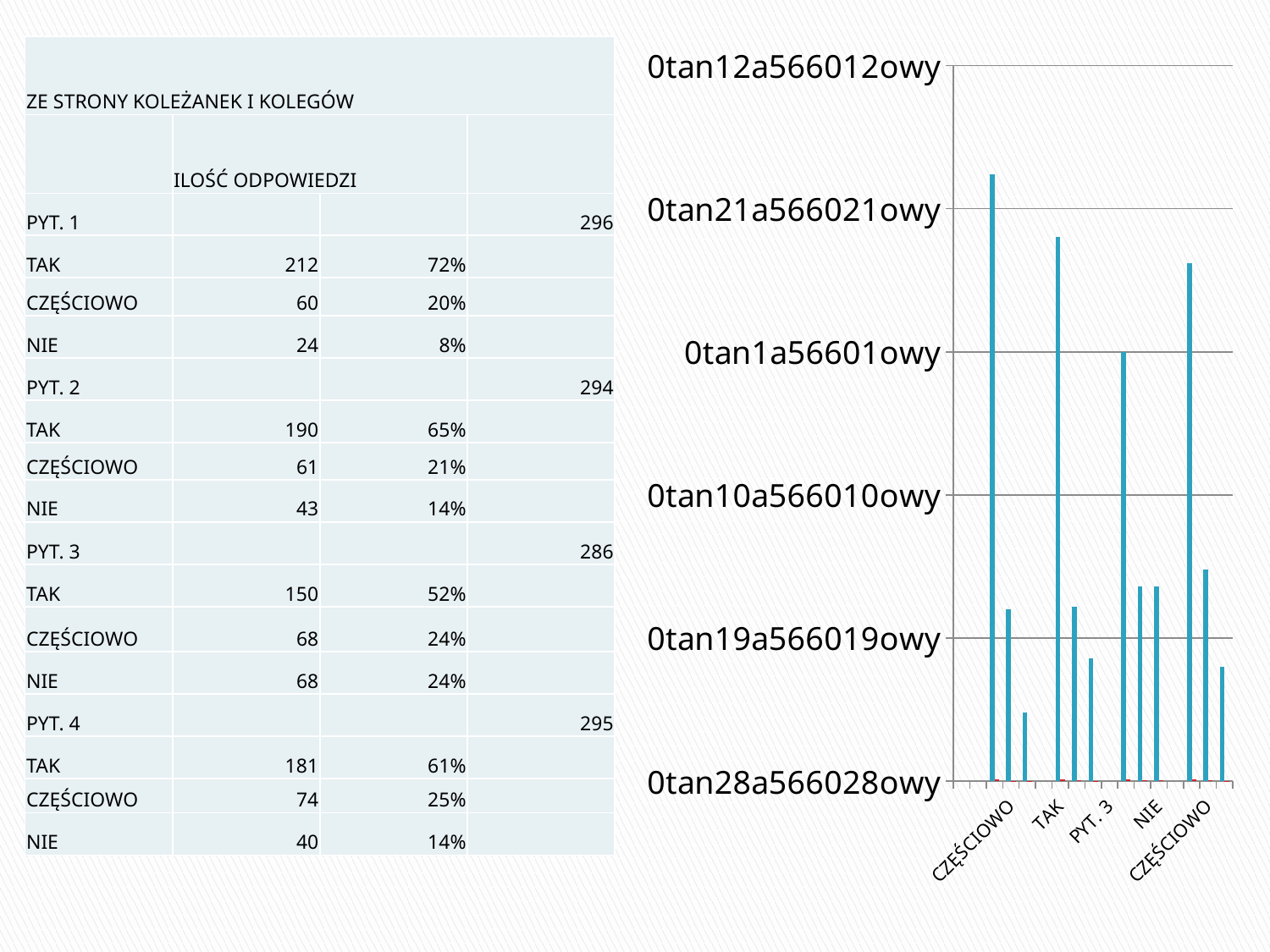
Which is taller in the chart, the leftmost bar or the rightmost bar? the leftmost bar Is the leftmost bar in the chart the tallest bar? yes Does the chart display a legend? no Which is shorter in the chart, the third bar from the left or the rightmost bar? the third bar from the left What kind of chart is shown on the right side of the slide? bar chart How many tall blue bars are plotted in the chart? 12 What colour are the main bars in the chart? blue